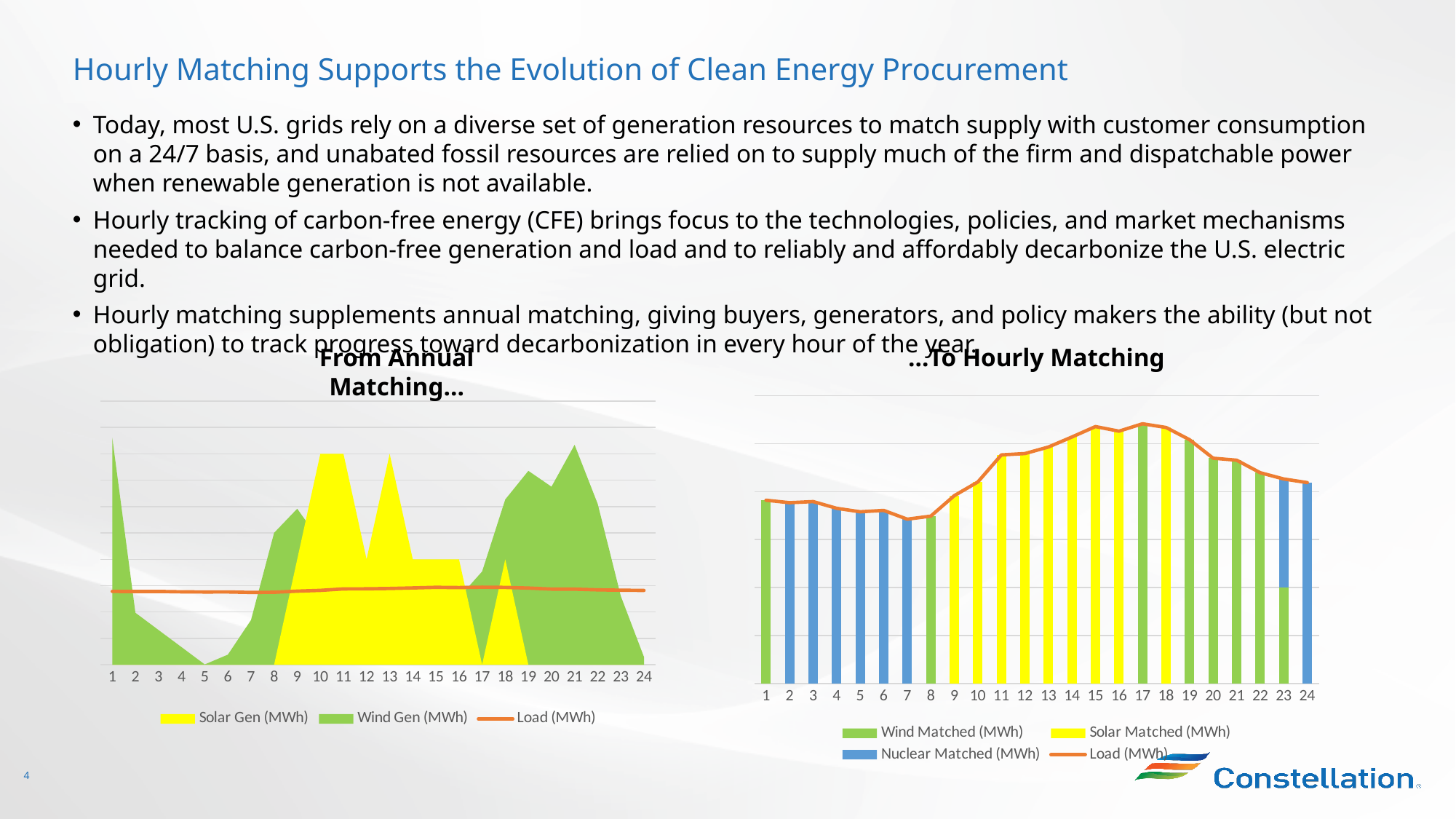
On the '...To Hourly Matching' chart, does the Load (MWh) line rise or fall from hour 17 to hour 24? Fall On the 'From Annual Matching...' chart, how many points are shown along the x axis? 24 On the '...To Hourly Matching' chart, how many hours are shown on the x axis? 24 On the '...To Hourly Matching' chart, does the Load (MWh) line rise or fall from hour 8 to hour 17? Rise What kind of chart is the 'From Annual Matching...' chart? Area chart with a line On the '...To Hourly Matching' chart, how many series does the legend list? 4 On the '...To Hourly Matching' chart, at which hour is Load (MWh) highest? 17 What kind of chart is the '...To Hourly Matching' chart? Bar chart with a line On the 'From Annual Matching...' chart, which colour represents Wind Gen (MWh)? Green On the '...To Hourly Matching' chart, which series is matched to load at hour 12? Solar Matched (MWh) On the 'From Annual Matching...' chart, how many series does the legend list? 3 On the '...To Hourly Matching' chart, which series is matched to load at hour 5? Nuclear Matched (MWh)